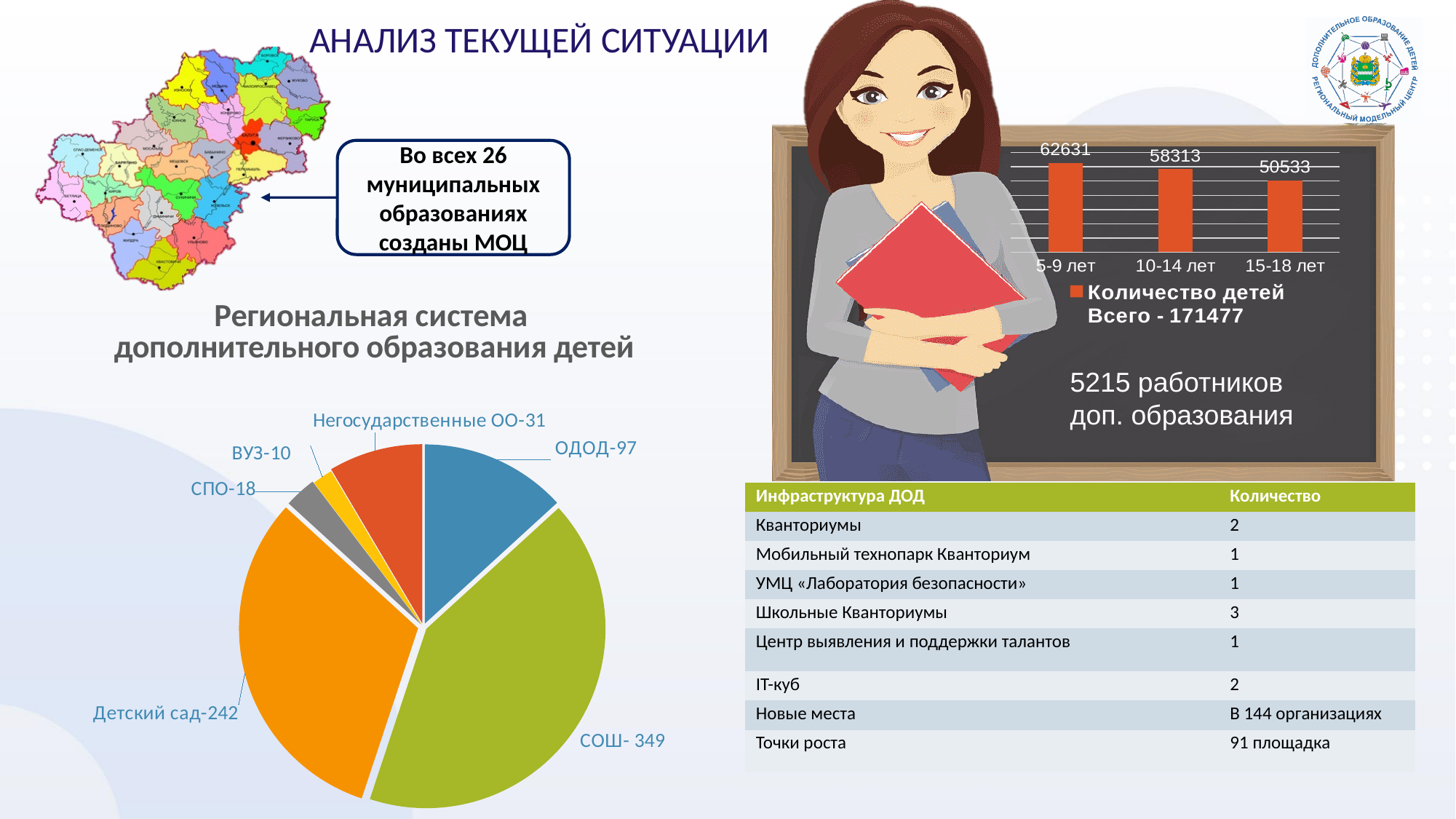
On the pie chart 'Региональная система дополнительного образования детей', which category has the smallest slice? ВУЗ On the bar chart on the chalkboard, what is the value for the 5-9 лет group? 62631 On the pie chart 'Региональная система дополнительного образования детей', how many slices are there? 6 What kind of chart is the chart titled 'Региональная система дополнительного образования детей'? pie chart On the bar chart on the chalkboard, which age group has the highest value? 5-9 лет On the pie chart 'Региональная система дополнительного образования детей', what is the value for Детский сад? 242 On the bar chart on the chalkboard, what is the value for the 15-18 лет group? 50533 On the bar chart on the chalkboard, what total number of children is stated in the legend? 171477 On the bar chart on the chalkboard, do the values rise or fall from left to right across the age groups? fall On the bar chart on the chalkboard, which age group has the lowest value? 15-18 лет On the bar chart on the chalkboard, what is the difference between the values for 5-9 лет and 10-14 лет? 4318 On the pie chart 'Региональная система дополнительного образования детей', which category has the largest slice? СОШ